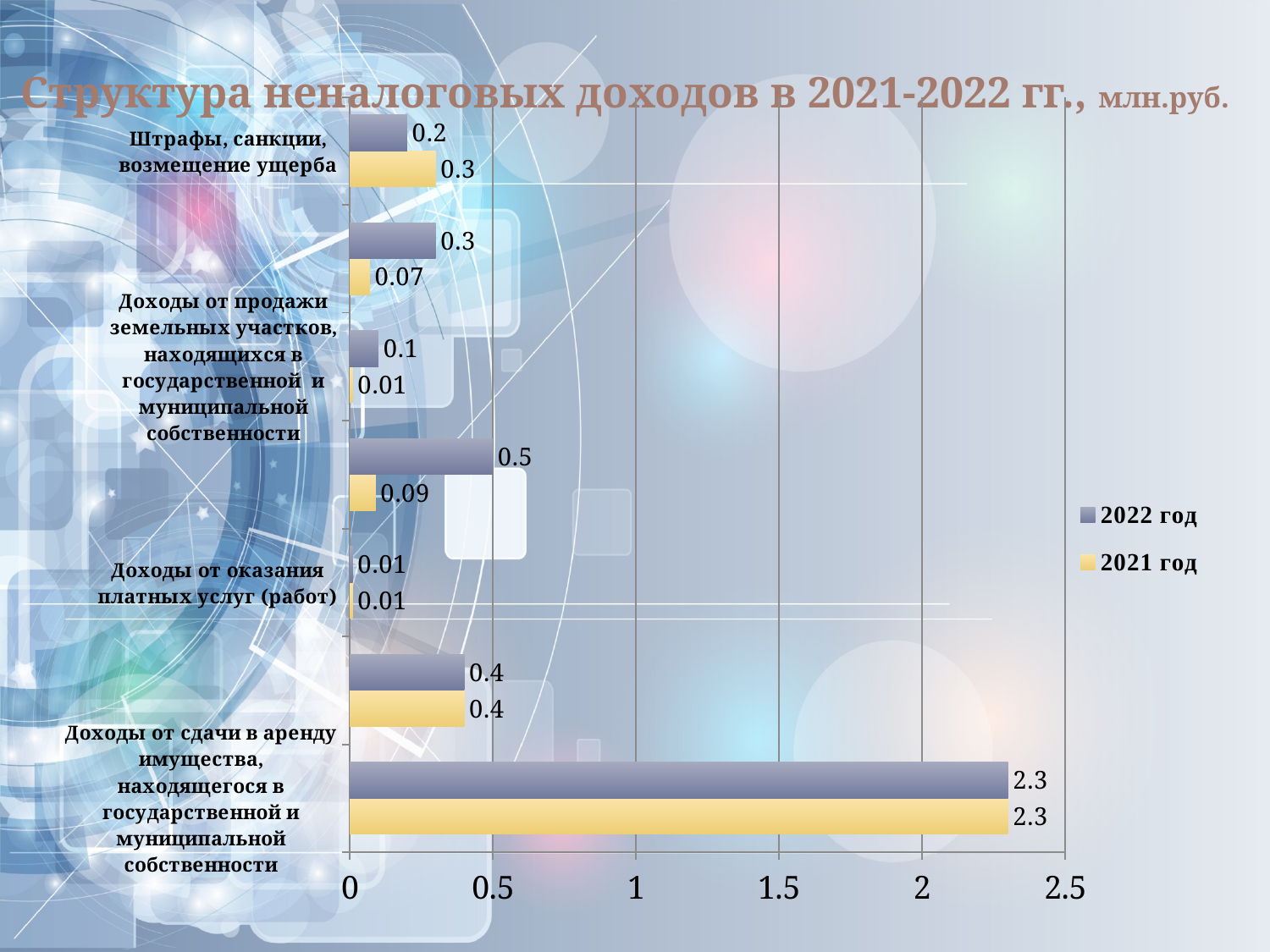
What kind of chart is shown on the slide? Bar chart Which category has the highest value in the 2022 год series? Доходы от сдачи в аренду имущества, находящегося в государственной и муниципальной собственности What colour represents the 2021 год series in the legend? Yellow What is the 2022 год value for 'Доходы от сдачи в аренду имущества, находящегося в государственной и муниципальной собственности'? 2.3 What is the 2022 год value for 'Доходы от продажи земельных участков, находящихся в государственной и муниципальной собственности'? 0.1 What is the value for 'Штрафы, санкции, возмещение ущерба' in the 2021 год series? 0.3 For 'Доходы от продажи земельных участков, находящихся в государственной и муниципальной собственности', what is the difference between the 2022 год and 2021 год values? 0.09 For 'Штрафы, санкции, возмещение ущерба', which series has the larger value, 2022 год or 2021 год? 2021 год What is the 2021 год value for 'Доходы от оказания платных услуг (работ)'? 0.01 How many series does the legend list? 2 For 'Штрафы, санкции, возмещение ущерба', what is the difference between the 2021 год and 2022 год values? 0.1 What is the value for 'Штрафы, санкции, возмещение ущерба' in the 2022 год series? 0.2